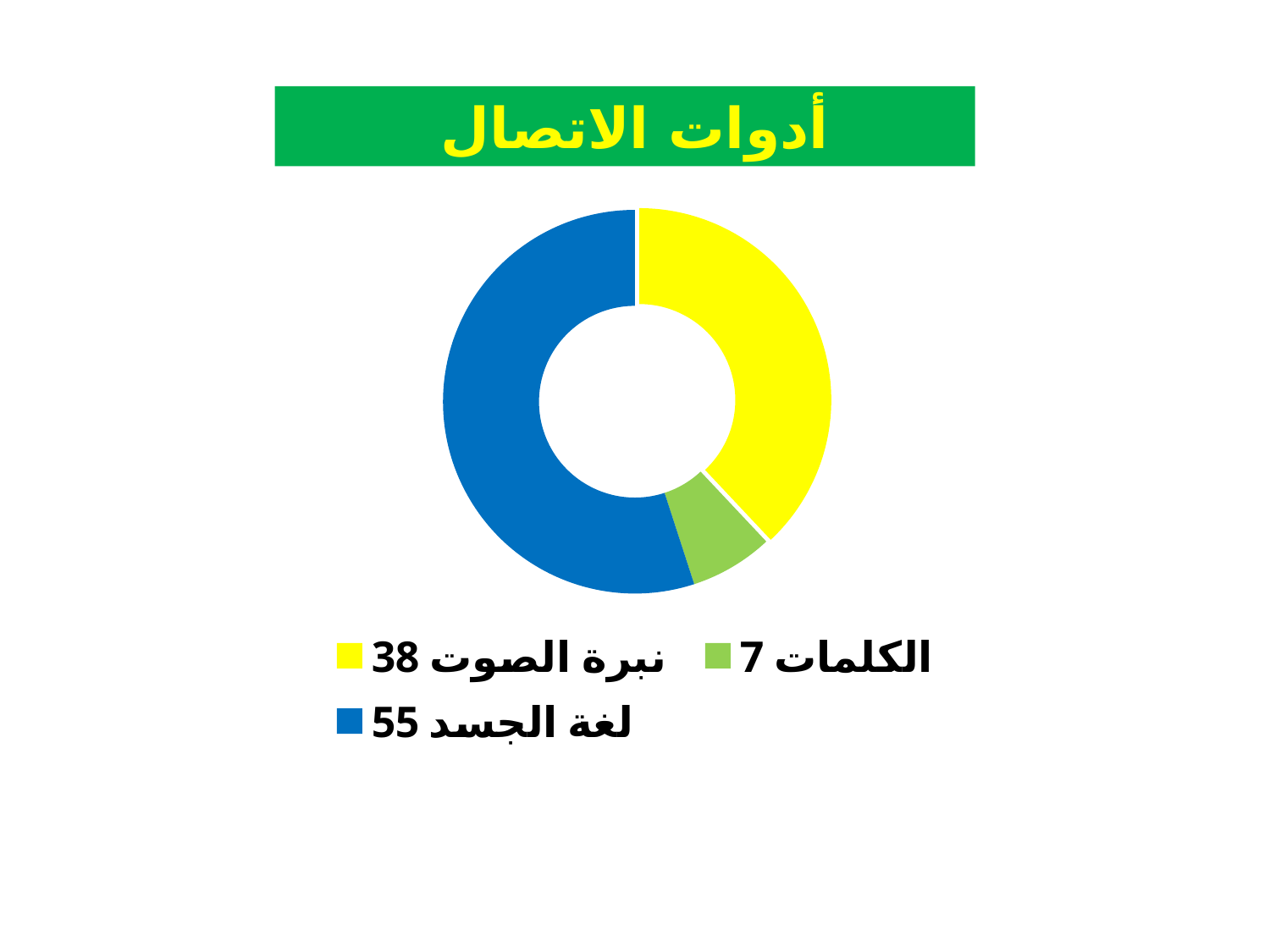
Which category has the largest value? لغة الجسد What is the value for لغة الجسد? 55 What is the title of the chart? أدوات الاتصال How many categories does the chart show? 3 What kind of chart is shown on the slide? doughnut chart Which is larger, the value for نبرة الصوت or the value for الكلمات? نبرة الصوت What is the difference between the values for نبرة الصوت and الكلمات? 31 Which category has the smallest value? الكلمات What is the difference between the values for لغة الجسد and نبرة الصوت? 17 What is the value for الكلمات? 7 What is the value for نبرة الصوت? 38 What share of the total does لغة الجسد represent? 55%